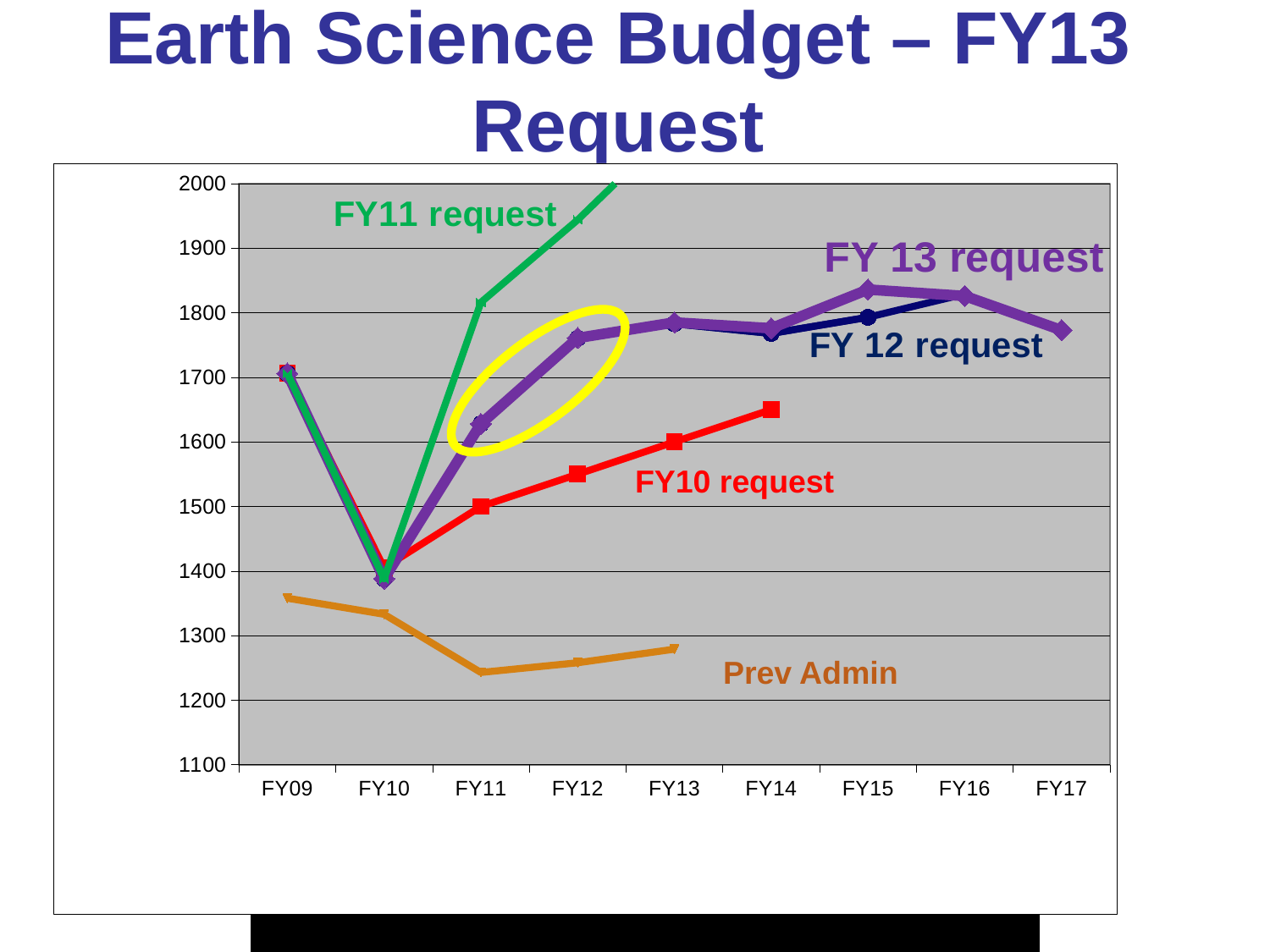
Is the value of the FY 13 request series at FY15 greater or less than 1800? greater Which series has the lowest value at FY13? Prev Admin Is the value of the Prev Admin series at FY11 greater or less than 1300? less Is the value of the FY 12 request series at FY14 greater or less than 1800? less How many fiscal years are shown on the x axis? 9 At FY12, which is larger: the FY 13 request series or the FY10 request series? FY 13 request Which series is drawn in green? FY11 request Does the FY10 request series rise or fall from FY10 to FY14? rise Which series reaches the highest value on the chart? FY11 request What kind of chart is shown on the slide? line chart Does the Prev Admin series rise or fall from FY09 to FY11? fall